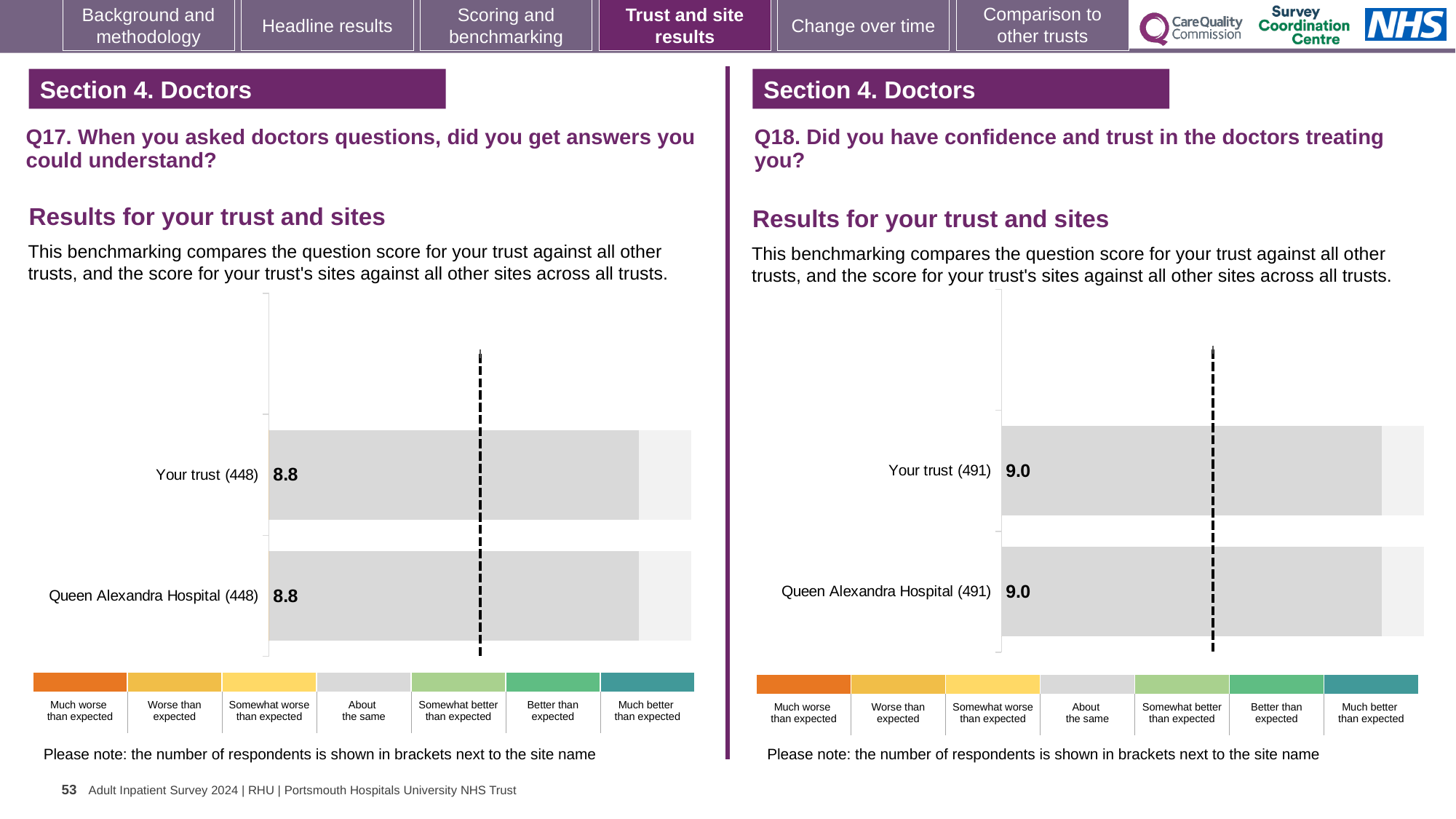
What is the difference between the Your trust score in the Q18 chart on the right and the Your trust score in the Q17 chart on the left? 0.2 In the Q17 chart on the left, how many respondents are shown in brackets next to Your trust? 448 In the Q17 chart on the left, what is the difference between the Your trust score and the Queen Alexandra Hospital score? 0 In the Q17 chart on the left, how many bars are plotted? 2 In the Q18 chart on the right, what is the score for Queen Alexandra Hospital? 9.0 What kind of chart is the Q17 chart on the left? Bar chart In the Q18 chart on the right, how many respondents are shown in brackets next to Queen Alexandra Hospital? 491 In the Q18 chart on the right, which benchmark category does the colour key label furthest to the right represent? Much better than expected In the Q17 chart on the left, what is the score for Queen Alexandra Hospital? 8.8 In the Q18 chart on the right, how many bars are plotted? 2 In the Q18 chart on the right, what is the score for Your trust? 9.0 In the Q17 chart on the left, what is the score for Your trust? 8.8